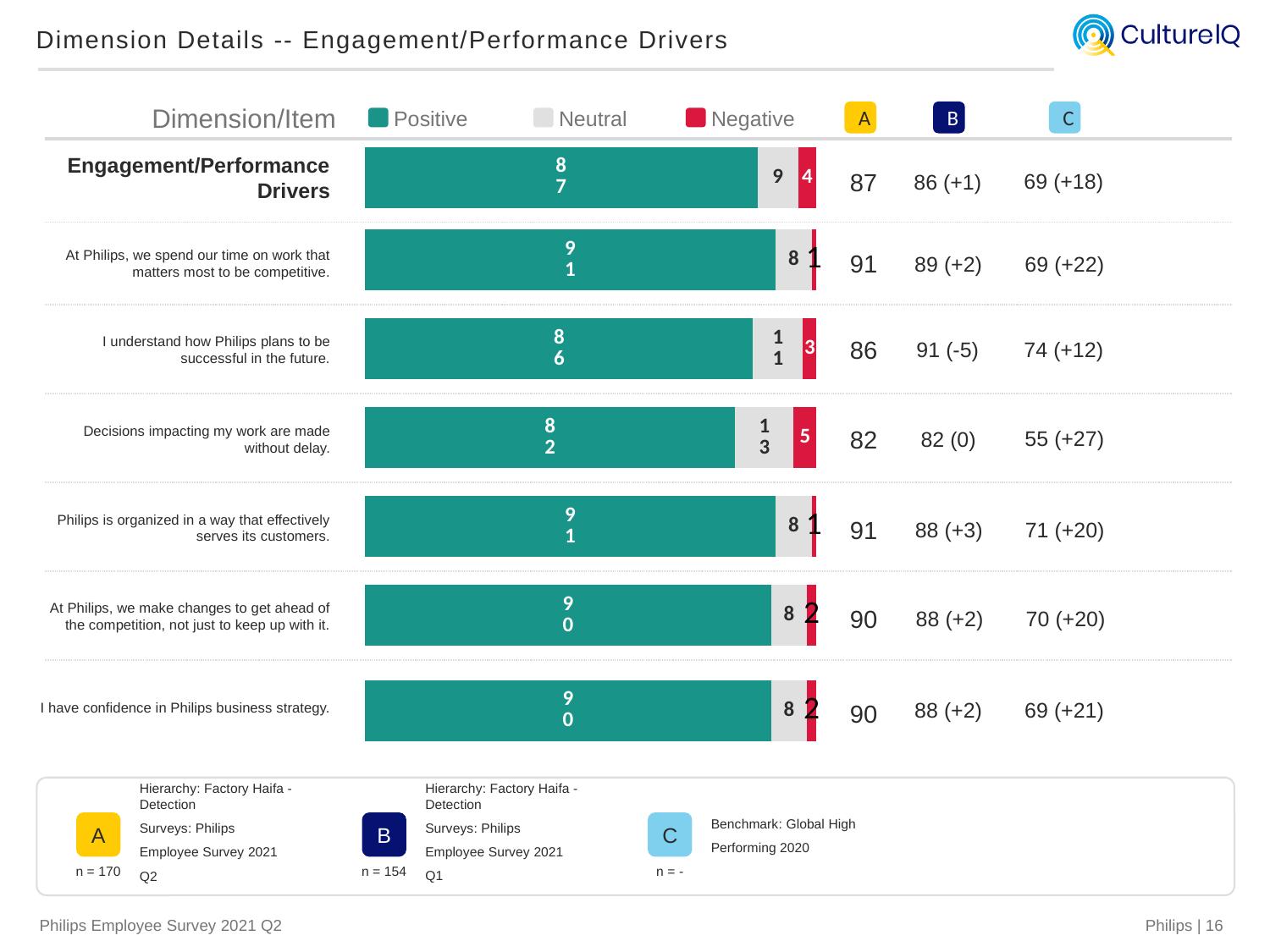
What colour represents the Negative series in the legend? Red What is the difference between the Positive values for "At Philips, we spend our time on work that matters most to be competitive." and "I understand how Philips plans to be successful in the future."? 5 How many rows (dimension and items) have bars on the slide? 7 What is the Negative value for the overall Engagement/Performance Drivers dimension? 4 What is the total of the Positive, Neutral and Negative values for "Philips is organized in a way that effectively serves its customers."? 100 Which has a larger Positive value: "I have confidence in Philips business strategy." or "Decisions impacting my work are made without delay."? I have confidence in Philips business strategy. What is the Neutral value for "I understand how Philips plans to be successful in the future."? 11 What kind of chart is used to show the Positive, Neutral and Negative responses? Stacked bar chart What is the Positive value for "Decisions impacting my work are made without delay."? 82 How many series does the legend list for the bars? 3 Which item has the lowest Positive value? Decisions impacting my work are made without delay. Which item has the highest Negative value? Decisions impacting my work are made without delay.